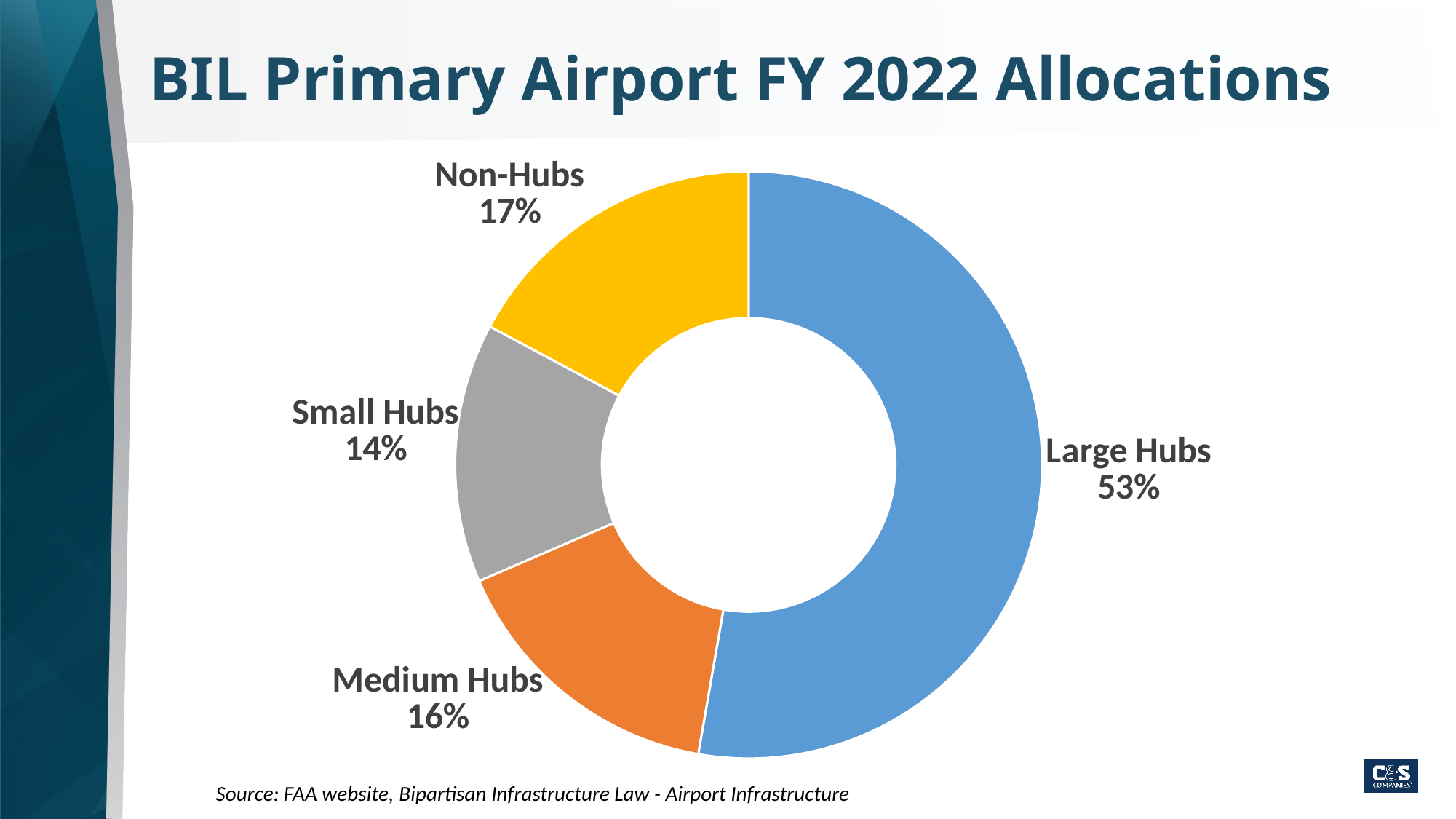
How many percentage points larger is the Large Hubs share than the Non-Hubs share? 36 Which hub category receives the smallest share of the FY 2022 allocations? Small Hubs What percentage of the allocations is shown for Small Hubs? 14% What share of the BIL Primary Airport FY 2022 allocations goes to Large Hubs? 53% How many hub categories are shown in the chart? 4 What colour is the Large Hubs segment of the chart? Blue What is the difference in percentage points between the Medium Hubs and Small Hubs shares? 2 Which hub category receives the largest share of the FY 2022 allocations? Large Hubs What kind of chart is used on this slide? Doughnut (pie) chart What percentage of the allocations is shown for Non-Hubs? 17% What percentage of the allocations is shown for Medium Hubs? 16% Which receives a larger share of the allocations, Non-Hubs or Medium Hubs? Non-Hubs